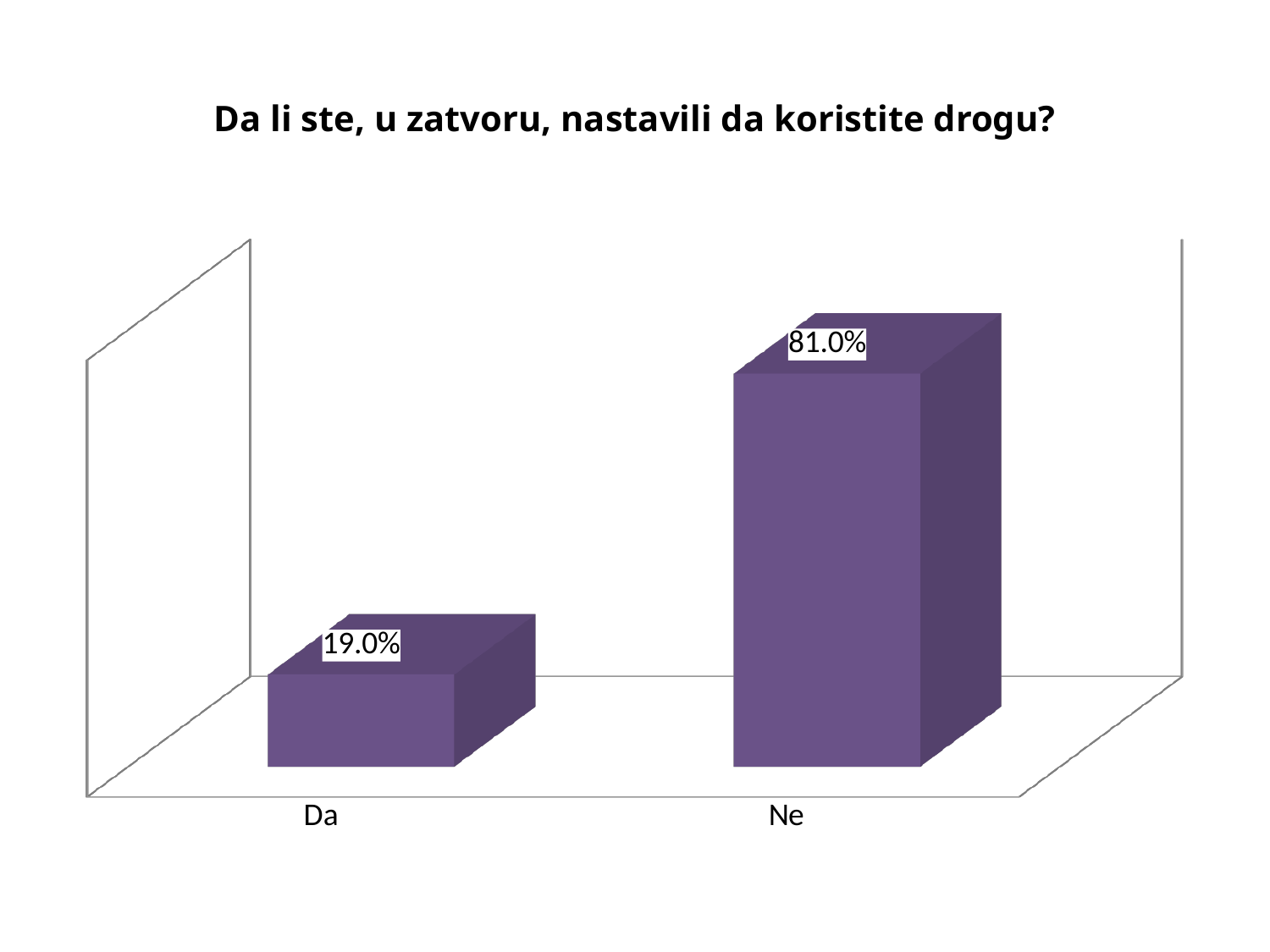
How many categories are shown in the chart? 2 What colour are the bars in the chart? Purple What is the title of the chart? Da li ste, u zatvoru, nastavili da koristite drogu? What is the value for "Ne"? 81.0% What is the value for "Da"? 19.0% What is the total of the values for "Da" and "Ne"? 100.0% Which category has the highest value? Ne What kind of chart is shown on the slide? Bar chart Which category has the lowest value? Da Which is larger, the value for "Da" or the value for "Ne"? Ne What is the difference between the values for "Ne" and "Da"? 62.0%